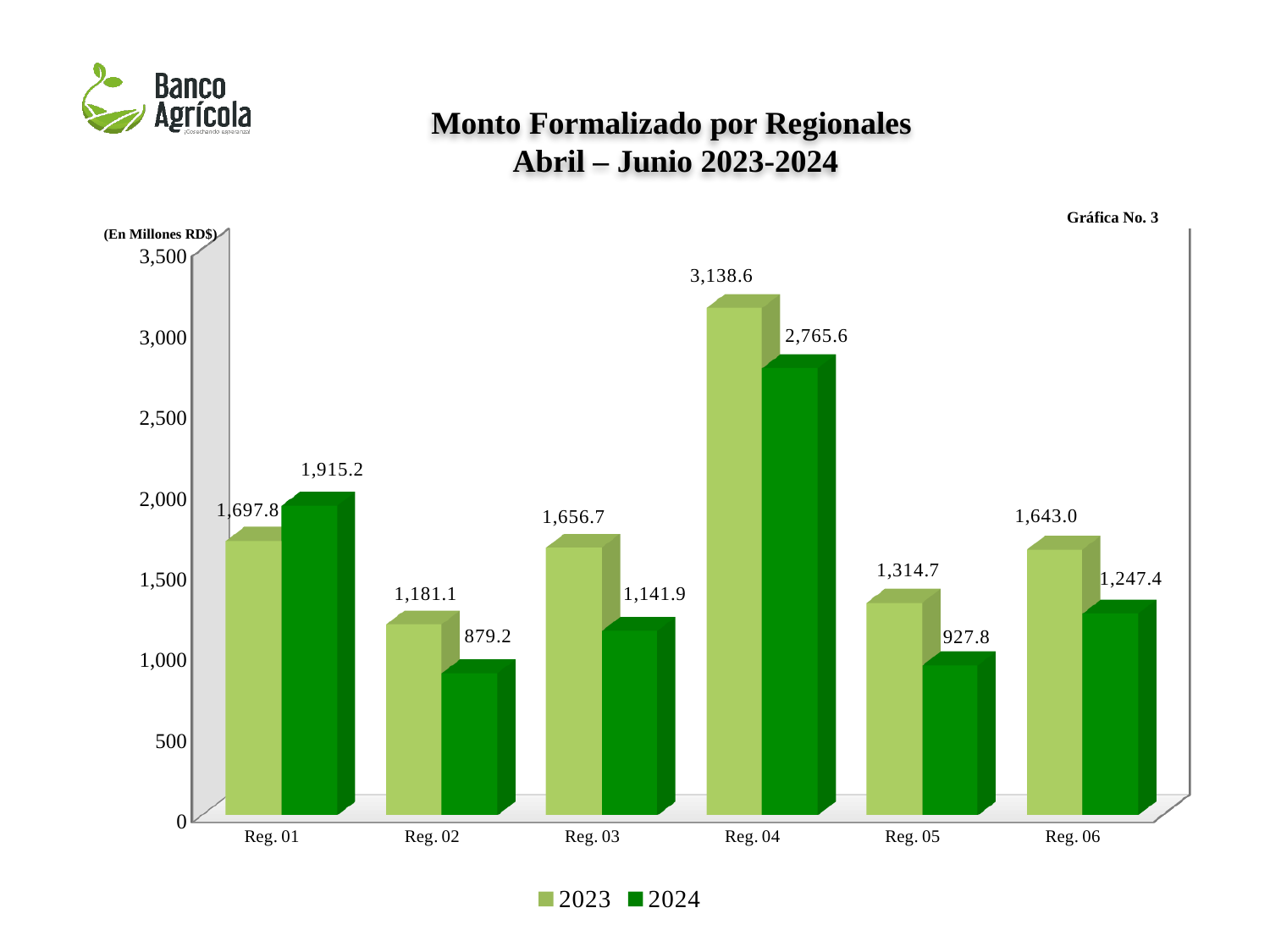
Which is larger for Reg. 05: the 2023 value or the 2024 value? 2023 How many series does the legend list? 2 What is the value for Reg. 06 in the 2023 series? 1,643.0 How many regions are shown on the x axis? 6 What kind of chart is shown on the slide? Bar chart What is the difference between the 2023 and 2024 values for Reg. 04? 373.0 Is the 2024 value for Reg. 03 greater or less than 1,000? greater What is the value for Reg. 04 in the 2023 series? 3,138.6 Which region has the highest value in the 2024 series? Reg. 04 Which region has the lowest value in the 2023 series? Reg. 02 What is the difference between the 2024 and 2023 values for Reg. 01? 217.4 What is the value for Reg. 02 in the 2024 series? 879.2